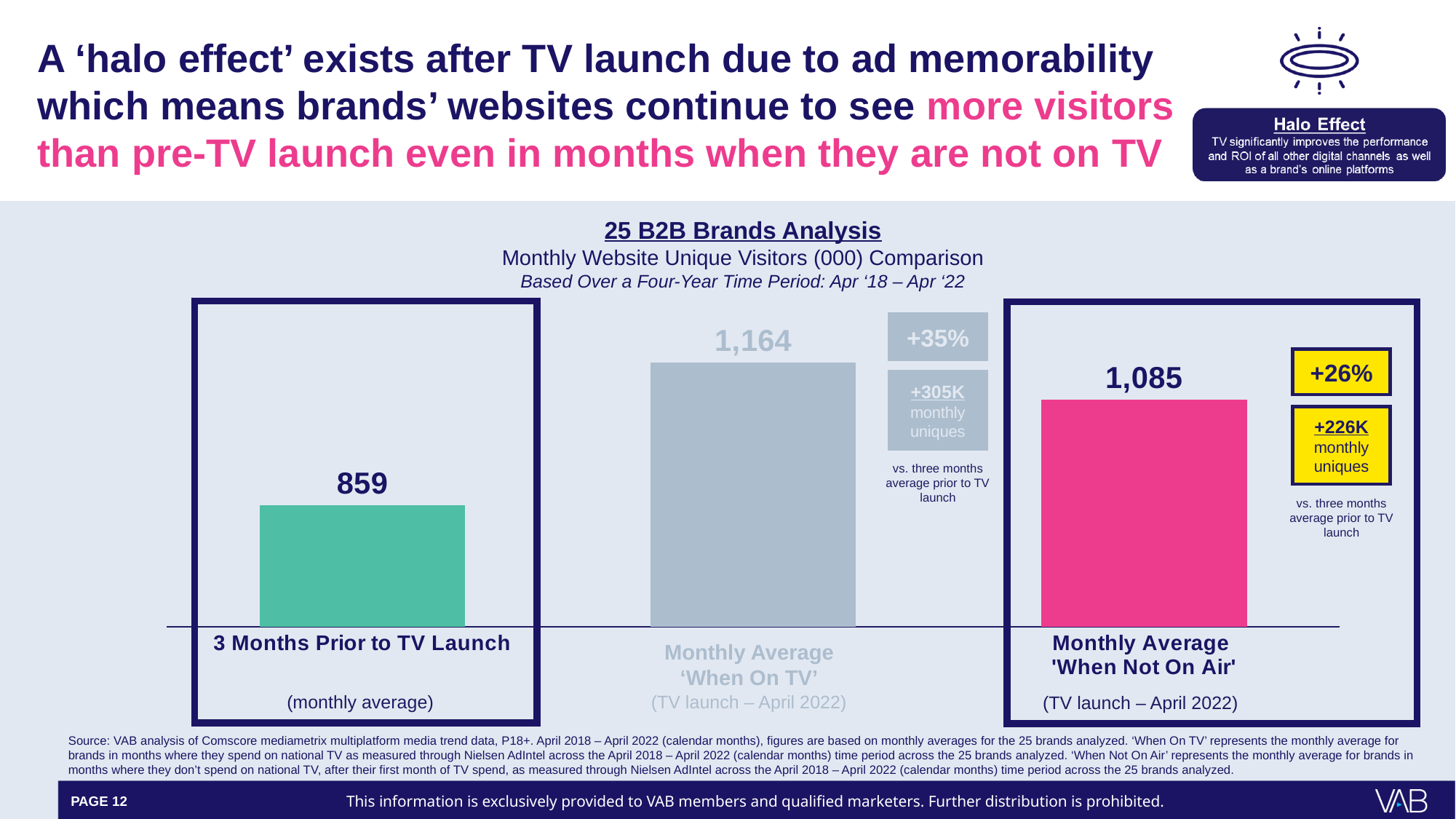
What is the Monthly Average 'When Not On Air' value for website unique visitors (000)? 1,085 Which category has the highest monthly website unique visitors? Monthly Average 'When On TV' What is the difference between the 'When On TV' monthly average and the 3 Months Prior to TV Launch monthly average? 305 Which category has the lowest monthly website unique visitors? 3 Months Prior to TV Launch What is the Monthly Average 'When On TV' value for website unique visitors (000)? 1,164 What is the title of the chart on the slide? 25 B2B Brands Analysis What is the difference between the 'When Not On Air' monthly average and the 3 Months Prior to TV Launch monthly average? 226 Which is larger, the Monthly Average 'When On TV' or the Monthly Average 'When Not On Air'? Monthly Average 'When On TV' What percentage increase is shown for the Monthly Average 'When Not On Air' versus the three months average prior to TV launch? +26% What is the monthly average of website unique visitors (000) for the 3 Months Prior to TV Launch? 859 What kind of chart is shown on the slide? Bar chart How many bars are shown in the chart? 3